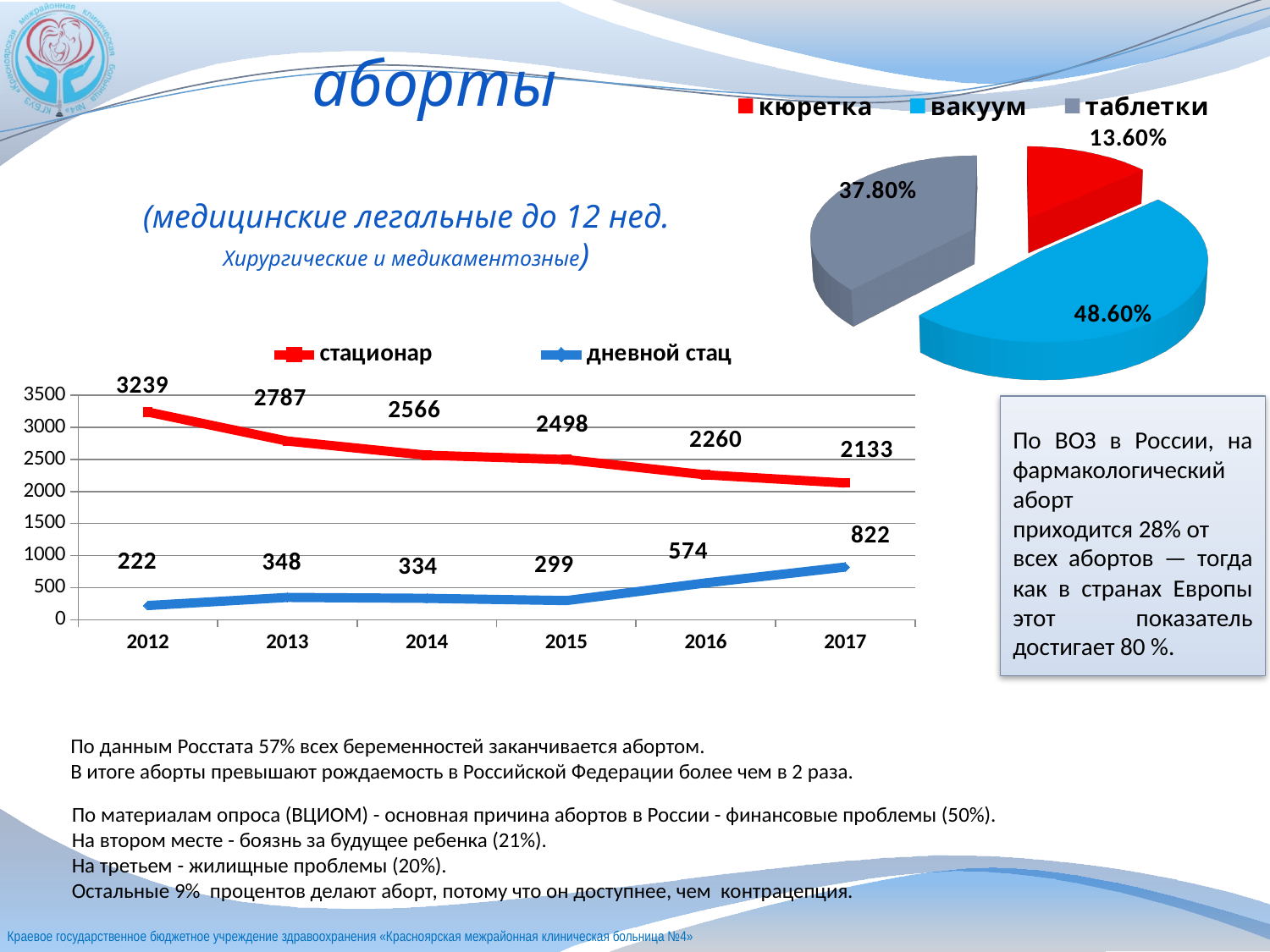
In the line chart on the left, which year has the highest value for дневной стац? 2017 In the line chart on the left, what is the value for стационар in 2012? 3239 In the line chart on the left, does the стационар series rise or fall from 2012 to 2017? fall In the line chart on the left, how many years are shown on the x axis? 6 In the pie chart on the right, which category has the smallest slice? кюретка In the line chart on the left, which is larger in 2016: стационар or дневной стац? стационар How many series does the legend of the line chart on the left list? 2 What kind of chart is the chart on the left? line chart In the line chart on the left, what is the value for дневной стац in 2017? 822 In the line chart on the left, which year has the lowest value for стационар? 2017 In the pie chart on the right, what share does вакуум have? 48.60% In the line chart on the left, what is the difference between the стационар values in 2012 and 2017? 1106